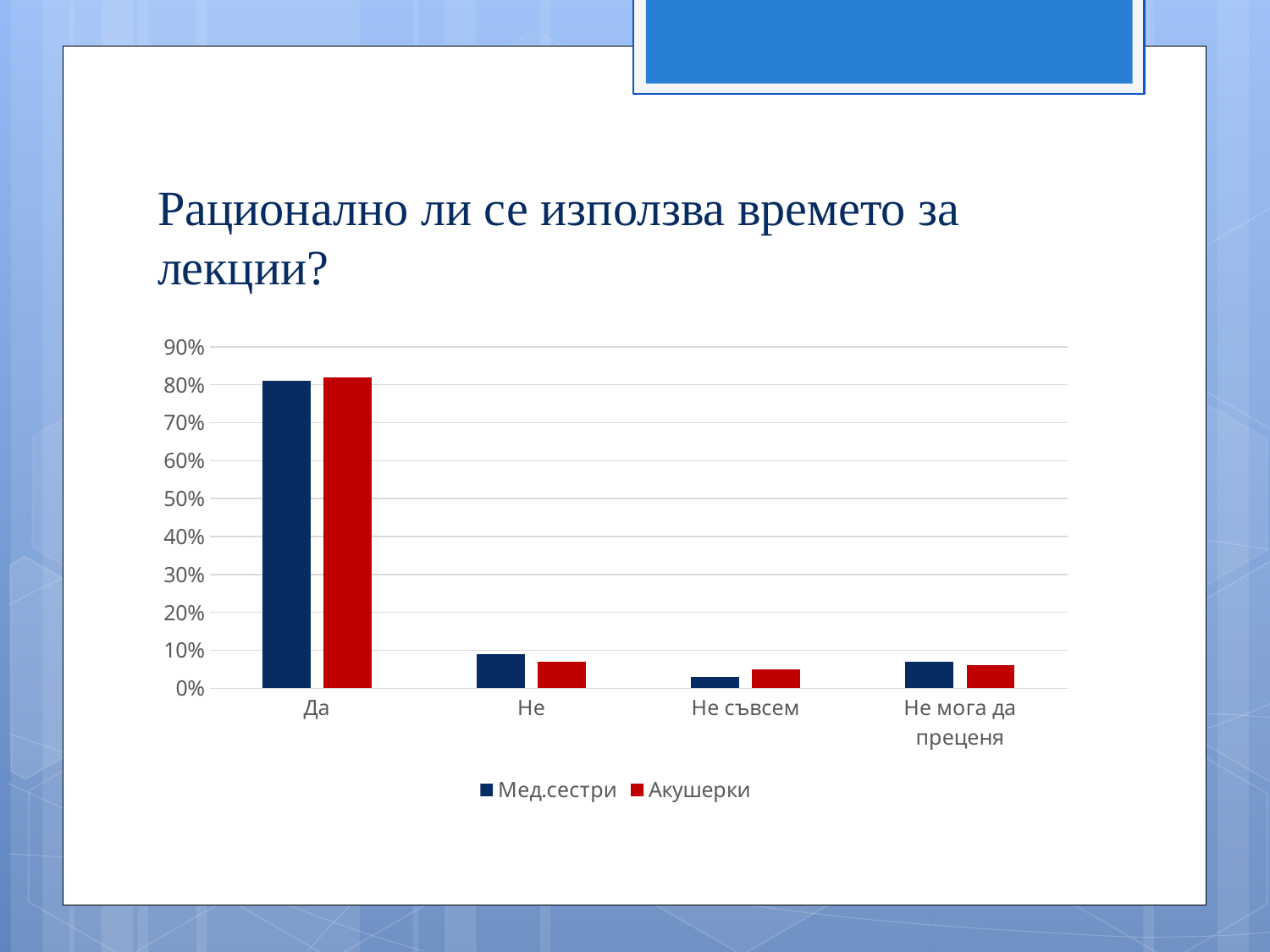
Is the value for Не for Акушерки greater or less than 20%? less Which category has the highest value for Акушерки? Да Is the value for Не съвсем for Акушерки greater or less than 10%? less Which category has the highest value for Мед.сестри? Да How many answer categories are shown on the x axis? 4 Is the value for Да for Мед.сестри greater or less than 70%? greater For Мед.сестри, which is larger: the value for Не or the value for Не съвсем? Не What is the title of the slide above the chart? Рационално ли се използва времето за лекции? Which series is shown in red in the legend? Акушерки What kind of chart is shown on the slide? bar chart How many series does the legend list? 2 Which category has the lowest value for Мед.сестри? Не съвсем